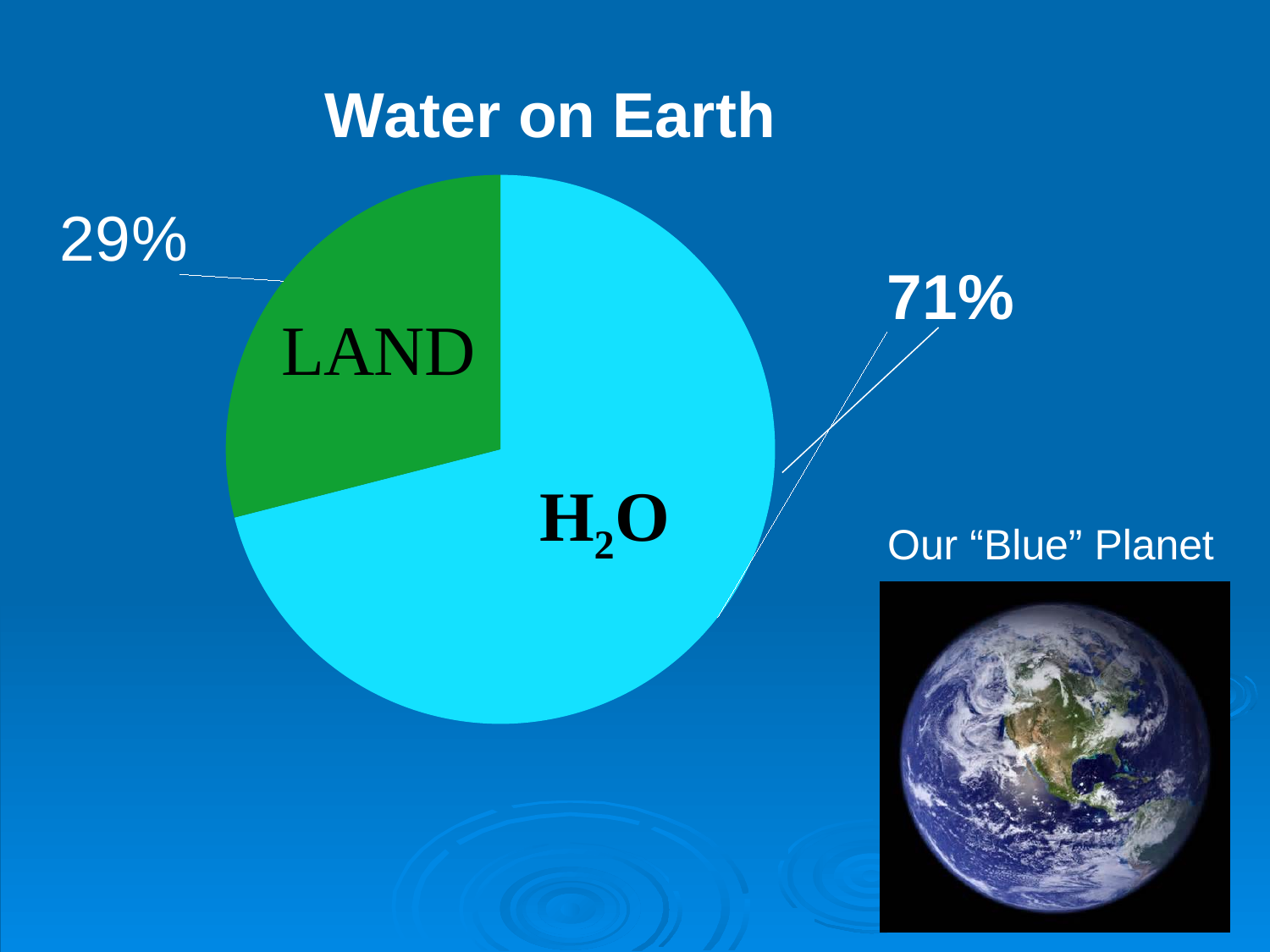
Which slice of the pie is the smallest? LAND What percentage of the pie is labelled LAND? 29% What share of the pie does the H2O slice represent? 71% What is the chart's title? Water on Earth Which is larger, the H2O slice or the LAND slice? H2O How many slices does the pie chart have? 2 What is the difference in percentage points between the H2O slice and the LAND slice? 42 What kind of chart is shown on the slide? pie chart What colour is the LAND slice of the pie? green What percentage of the pie is labelled H2O? 71% Which slice of the pie is the largest? H2O